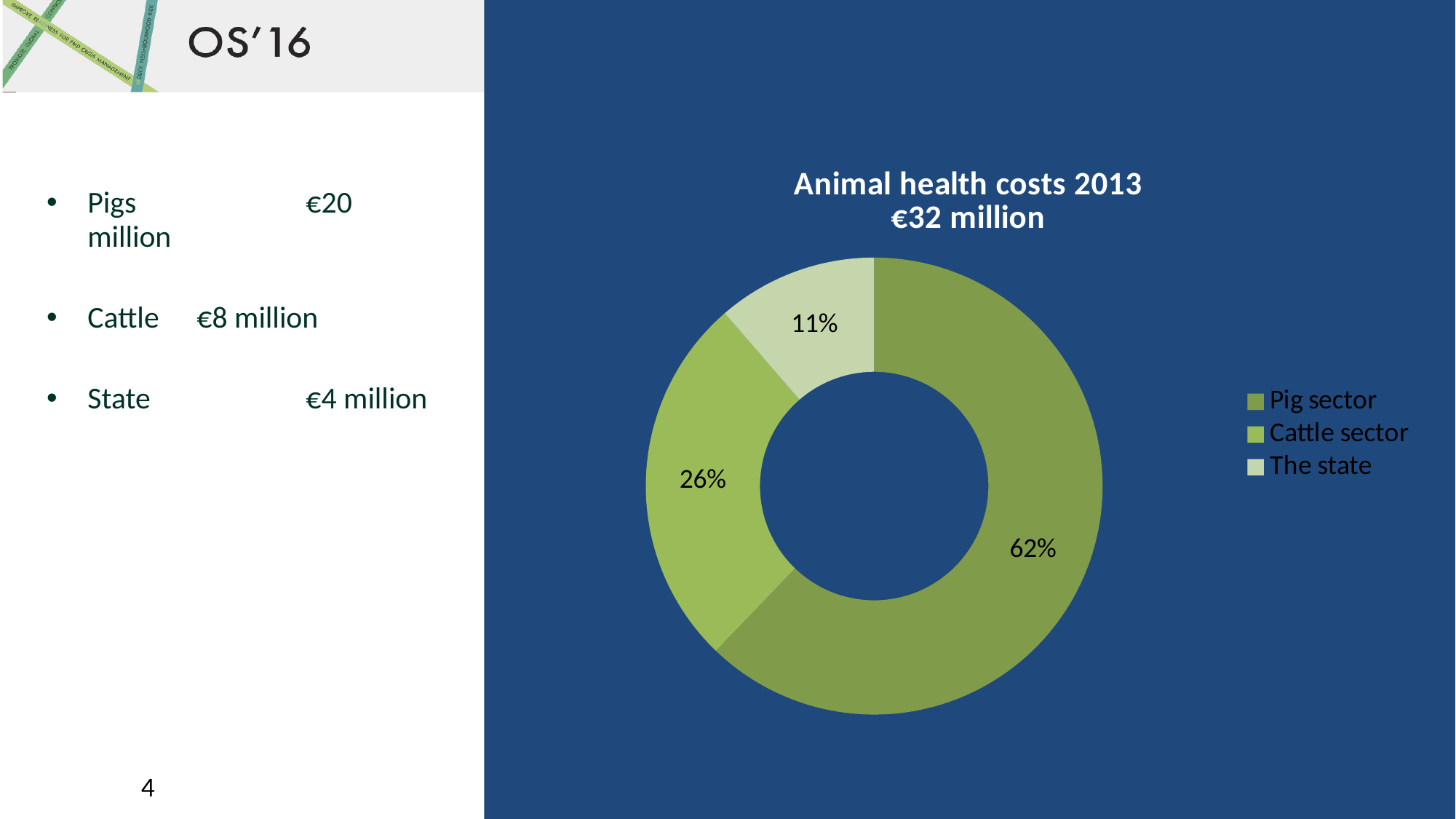
Which category has the largest share of the donut chart? Pig sector What share of the donut chart does the Cattle sector account for? 26% What is the difference in percentage points between the Pig sector and Cattle sector shares? 36 Which category has the smallest share of the donut chart? The state How many entries does the chart legend list? 3 How many categories are shown in the donut chart? 3 What is the title of the chart? Animal health costs 2013 €32 million What share of the donut chart does the Pig sector account for? 62% What kind of chart is shown on the slide? Donut (pie) chart What share of the donut chart does The state account for? 11% Which has a larger share, the Cattle sector or The state? Cattle sector What is the difference in percentage points between the Cattle sector and The state shares? 15